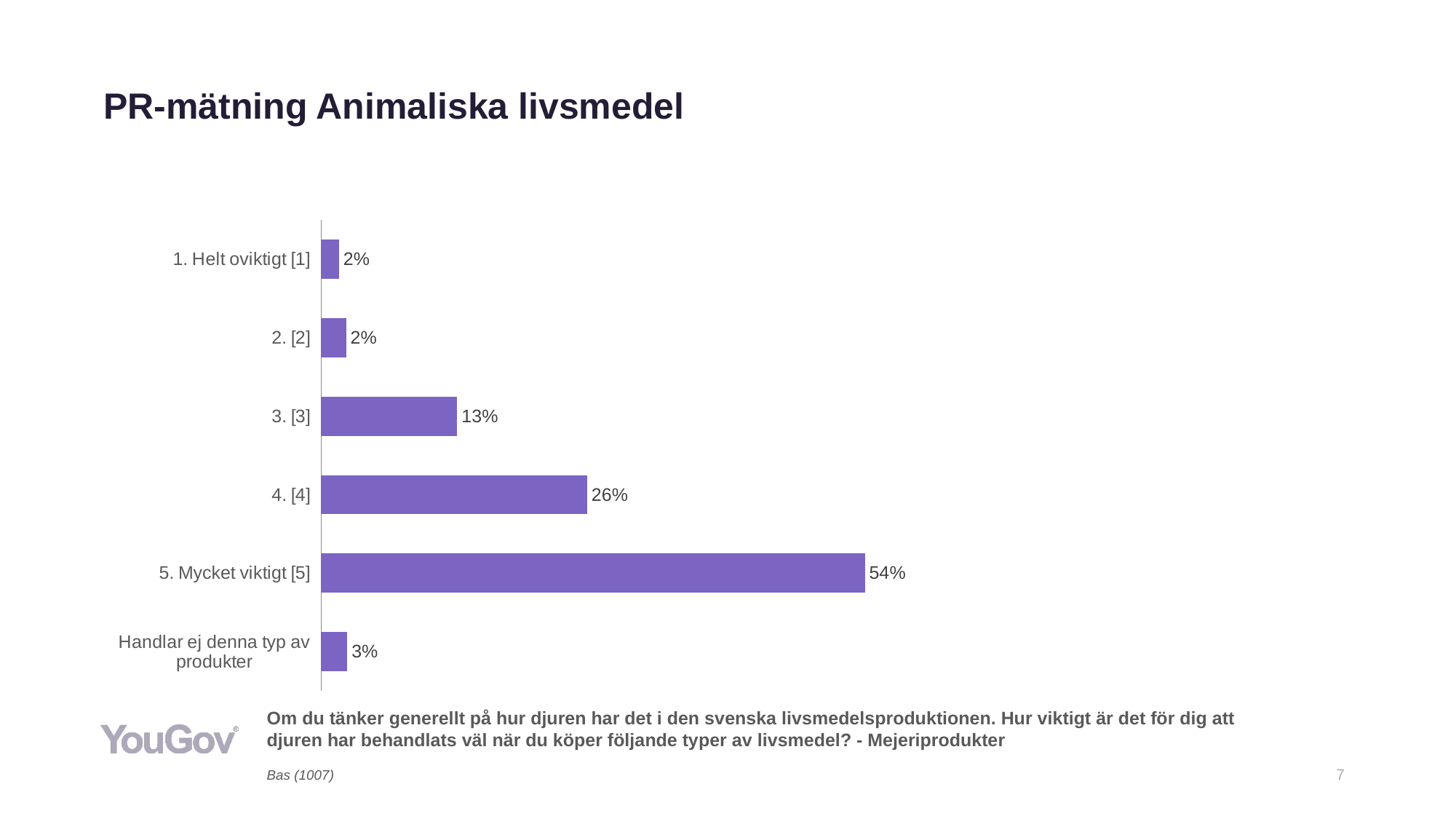
Which is larger, the value for "3. [3]" or the value for "Handlar ej denna typ av produkter"? 3. [3] What is the value for "3. [3]"? 13% How many categories are shown in the chart? 6 What is the difference between the values for "5. Mycket viktigt [5]" and "4. [4]"? 28% What is the value for "5. Mycket viktigt [5]"? 54% Which category has the highest value? 5. Mycket viktigt [5] What is the value for "Handlar ej denna typ av produkter"? 3% What is the base (Bas) size shown below the chart? 1007 What is the difference between the values for "4. [4]" and "3. [3]"? 13% What kind of chart is shown on the slide? Bar chart What is the combined value of "4. [4]" and "5. Mycket viktigt [5]"? 80% What is the value for "4. [4]"? 26%